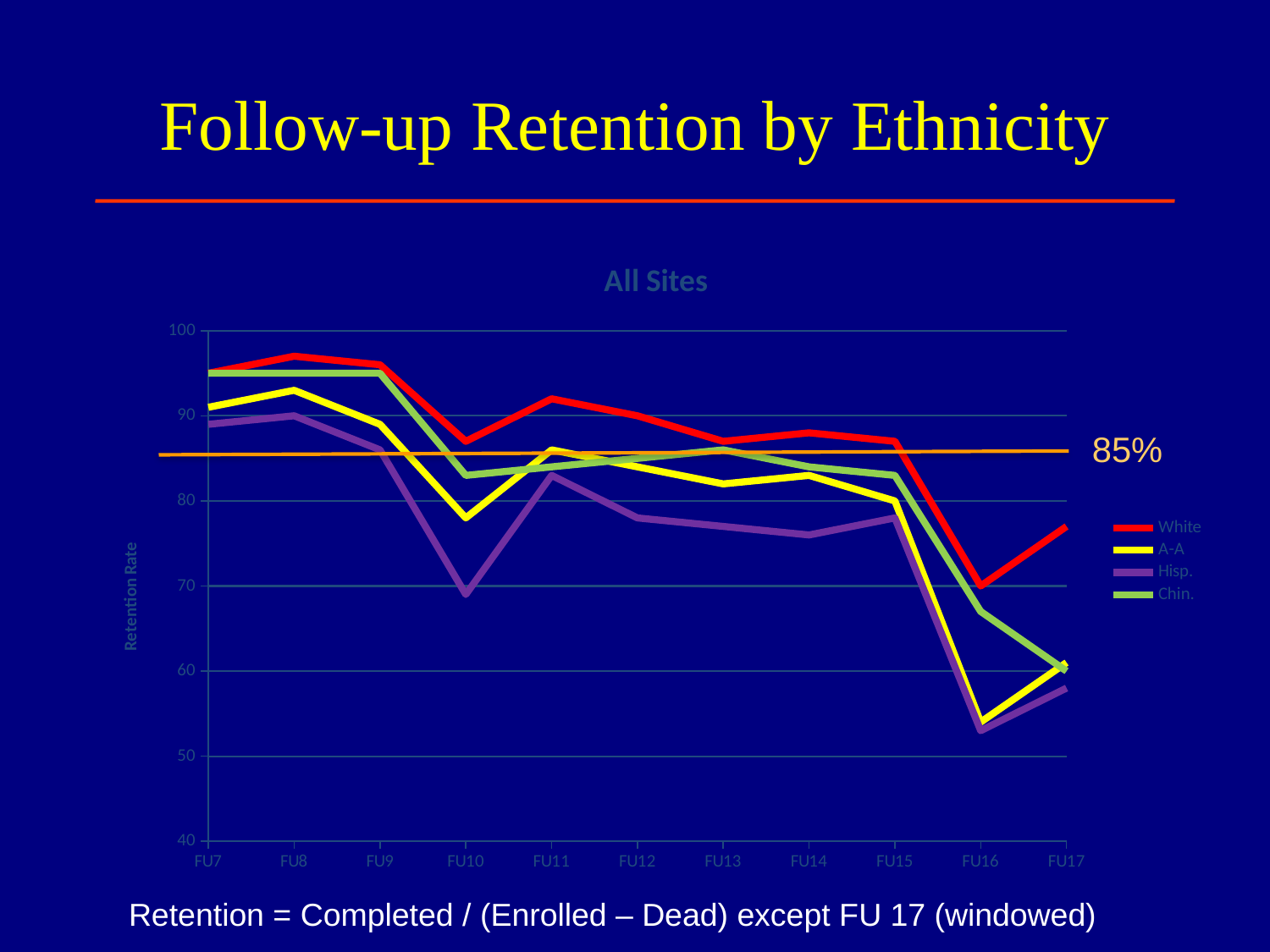
Is the value for White at FU11 greater or less than 90? greater What is the label on the y axis of the chart? Retention Rate At FU10, which series has the lowest retention rate? Hisp. What is the title of the chart? All Sites How many series does the legend of the chart list? 4 What kind of chart is shown on the slide? Line chart Does the White series rise or fall from FU15 to FU16? Fall Is the value for Hisp. at FU16 greater or less than 60? less How many follow-up points are shown along the x axis of the chart? 11 Is the value for White at FU17 greater or less than 70? greater At FU17, which series has the highest retention rate? White